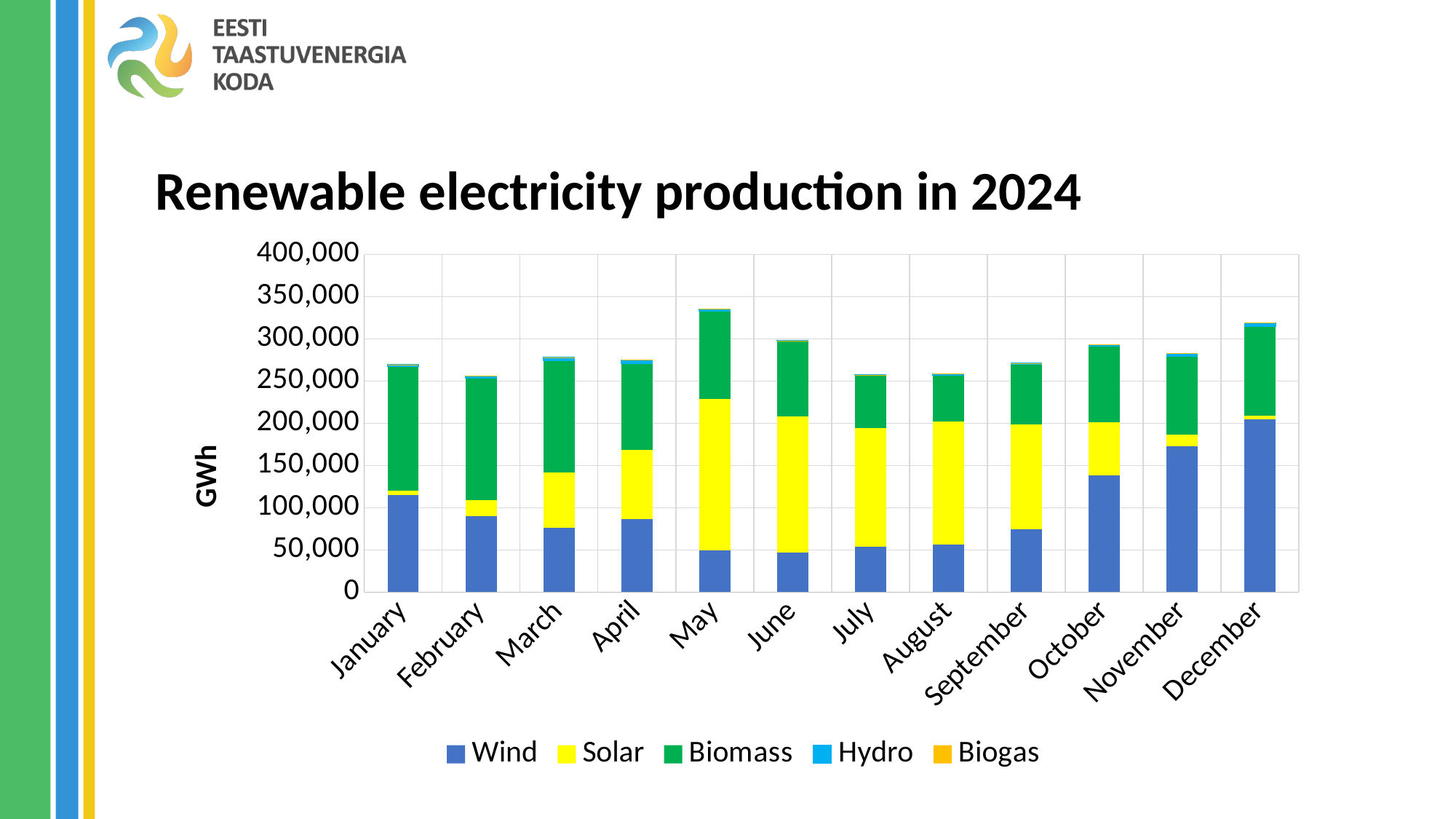
What is the title of the chart? Renewable electricity production in 2024 Which month has the highest total renewable electricity production? May Is the total production for May greater or less than 300,000? greater Is the Wind value for October greater or less than 100,000? greater What is the label on the y axis of the chart? GWh How many series does the chart legend list? 5 What kind of chart is shown on the slide? stacked bar chart Which is larger, the total production for May or the total production for June? May How many months are shown on the x axis of the chart? 12 Is the total production for February greater or less than 300,000? less Which is larger, the Wind value for December or the Wind value for January? December